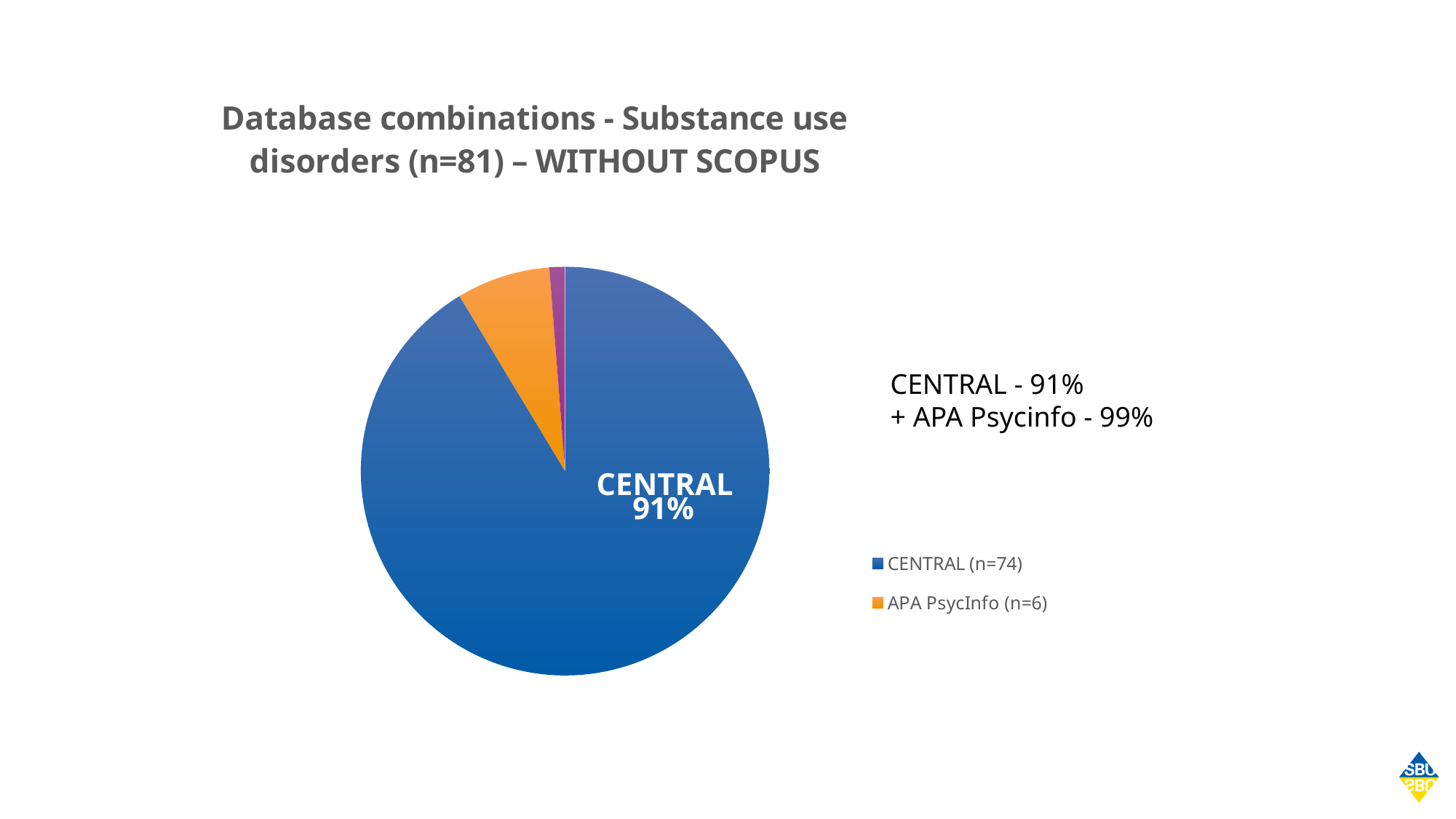
Which slice of the pie is the largest? CENTRAL According to the legend, what is the n value for APA PsycInfo? 6 What kind of chart is shown on the slide? pie chart Which is larger, the CENTRAL slice or the APA PsycInfo slice? CENTRAL How many entries does the legend list? 2 What share of the pie does the CENTRAL slice represent? 91% What is the difference between the n values for CENTRAL and APA PsycInfo shown in the legend? 68 According to the text on the slide, what cumulative percentage is reached by combining CENTRAL with APA Psycinfo? 99% What is the title of the chart? Database combinations - Substance use disorders (n=81) – WITHOUT SCOPUS According to the legend, what is the n value for CENTRAL? 74 What colour is the CENTRAL slice of the pie? blue